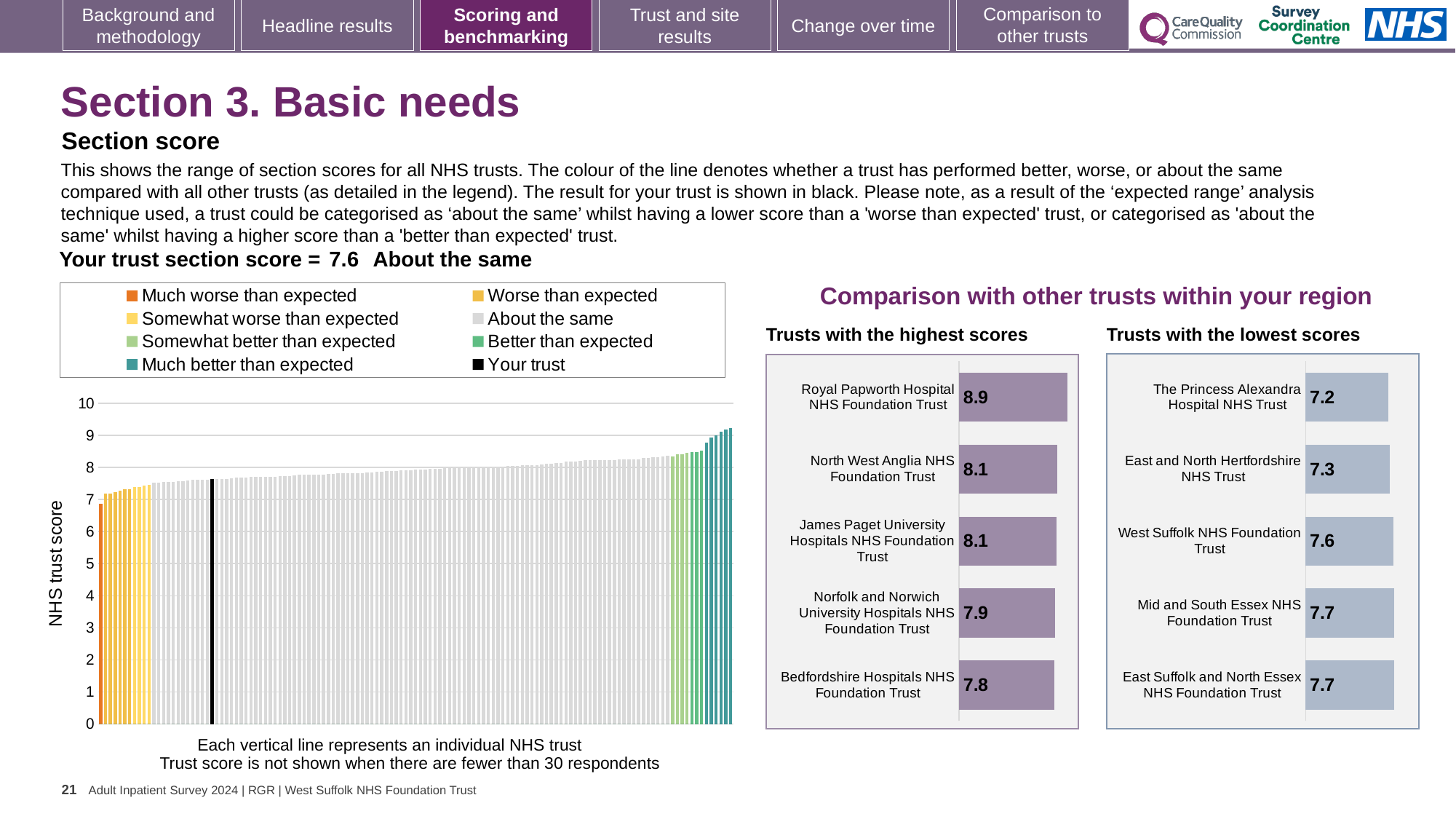
What kind of chart is the large chart on the left showing NHS trust scores? bar chart In the large chart on the left, is the value of the highest bar greater or less than 9? greater In the large chart on the left, how many entries does the legend list? 8 In the 'Trusts with the lowest scores' chart, which trust has the lowest score? The Princess Alexandra Hospital NHS Trust In the 'Trusts with the highest scores' chart, how many trusts are shown? 5 In the 'Trusts with the highest scores' chart, what is the difference between the scores of Royal Papworth Hospital NHS Foundation Trust and Bedfordshire Hospitals NHS Foundation Trust? 1.1 In the large chart on the left, do the trust scores rise or fall from left to right? rise In the 'Trusts with the lowest scores' chart, which has the higher score: East and North Hertfordshire NHS Trust or West Suffolk NHS Foundation Trust? West Suffolk NHS Foundation Trust What is the section score for your trust shown on the slide? 7.6 In the 'Trusts with the lowest scores' chart, what is the difference between the scores of West Suffolk NHS Foundation Trust and The Princess Alexandra Hospital NHS Trust? 0.4 In the 'Trusts with the highest scores' chart, what is the score for Royal Papworth Hospital NHS Foundation Trust? 8.9 In the 'Trusts with the highest scores' chart, which trust has the lowest score? Bedfordshire Hospitals NHS Foundation Trust